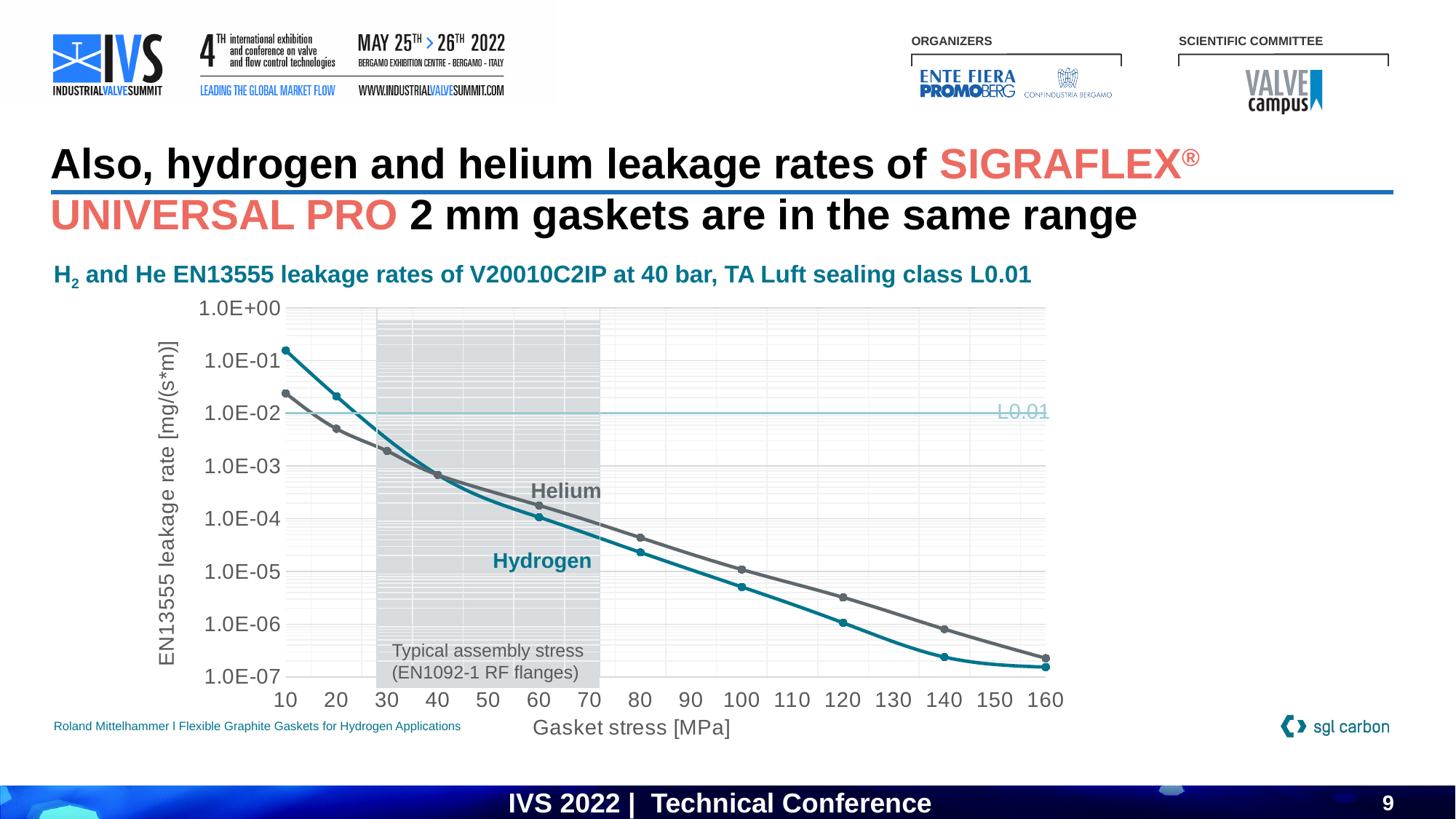
At a gasket stress of 10 MPa, which series has the higher leakage rate, Hydrogen or Helium? Hydrogen Is the Hydrogen leakage rate at 10 MPa greater or less than 1.0E-01? greater Is the Helium leakage rate at 120 MPa greater or less than 1.0E-05? less Is the Helium leakage rate at 10 MPa greater or less than 1.0E-02? greater At a gasket stress of 100 MPa, which series has the higher leakage rate, Hydrogen or Helium? Helium Do the leakage rates rise or fall as gasket stress increases? fall What kind of chart is shown on the slide? line chart What is the label of the x axis? Gasket stress [MPa] What is the title of the chart? H2 and He EN13555 leakage rates of V20010C2IP at 40 bar, TA Luft sealing class L0.01